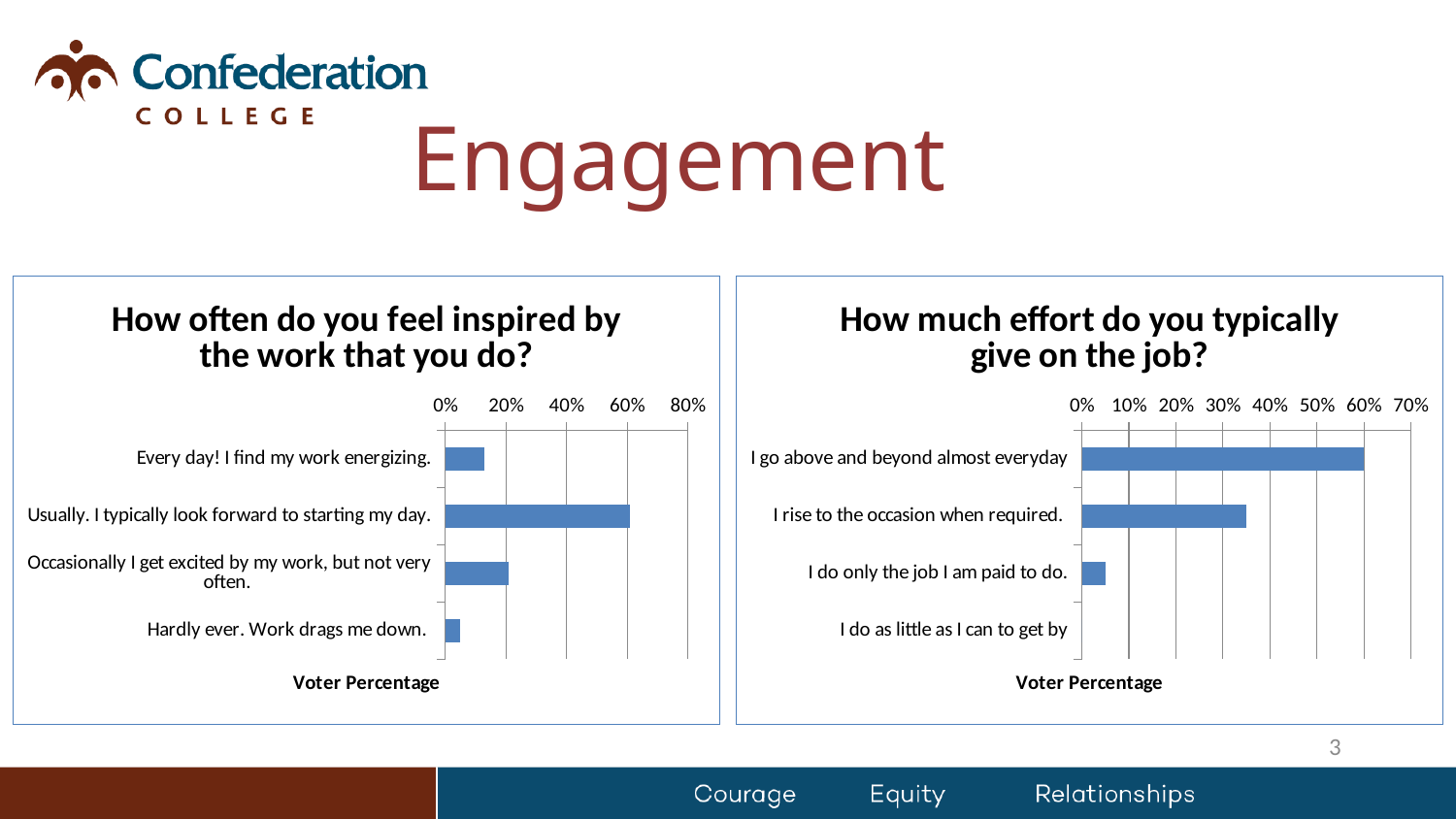
In the chart titled "How often do you feel inspired by the work that you do?", which category has the lowest voter percentage? Hardly ever. Work drags me down. In the chart titled "How often do you feel inspired by the work that you do?", how many categories are shown? 4 What kind of chart is the chart titled "How much effort do you typically give on the job?"? bar chart In the chart titled "How often do you feel inspired by the work that you do?", is the value for "Hardly ever. Work drags me down." greater or less than 20%? less In the chart titled "How much effort do you typically give on the job?", which category has the highest voter percentage? I go above and beyond almost everyday In the chart titled "How often do you feel inspired by the work that you do?", is the value for "Usually. I typically look forward to starting my day." greater or less than 40%? greater In the chart titled "How much effort do you typically give on the job?", is the value for "I go above and beyond almost everyday" greater or less than 50%? greater In the chart titled "How often do you feel inspired by the work that you do?", which category has the highest voter percentage? Usually. I typically look forward to starting my day. In the chart titled "How much effort do you typically give on the job?", which is larger: the value for "I rise to the occasion when required." or the value for "I do only the job I am paid to do."? I rise to the occasion when required. In the chart titled "How much effort do you typically give on the job?", which category has the lowest voter percentage? I do as little as I can to get by